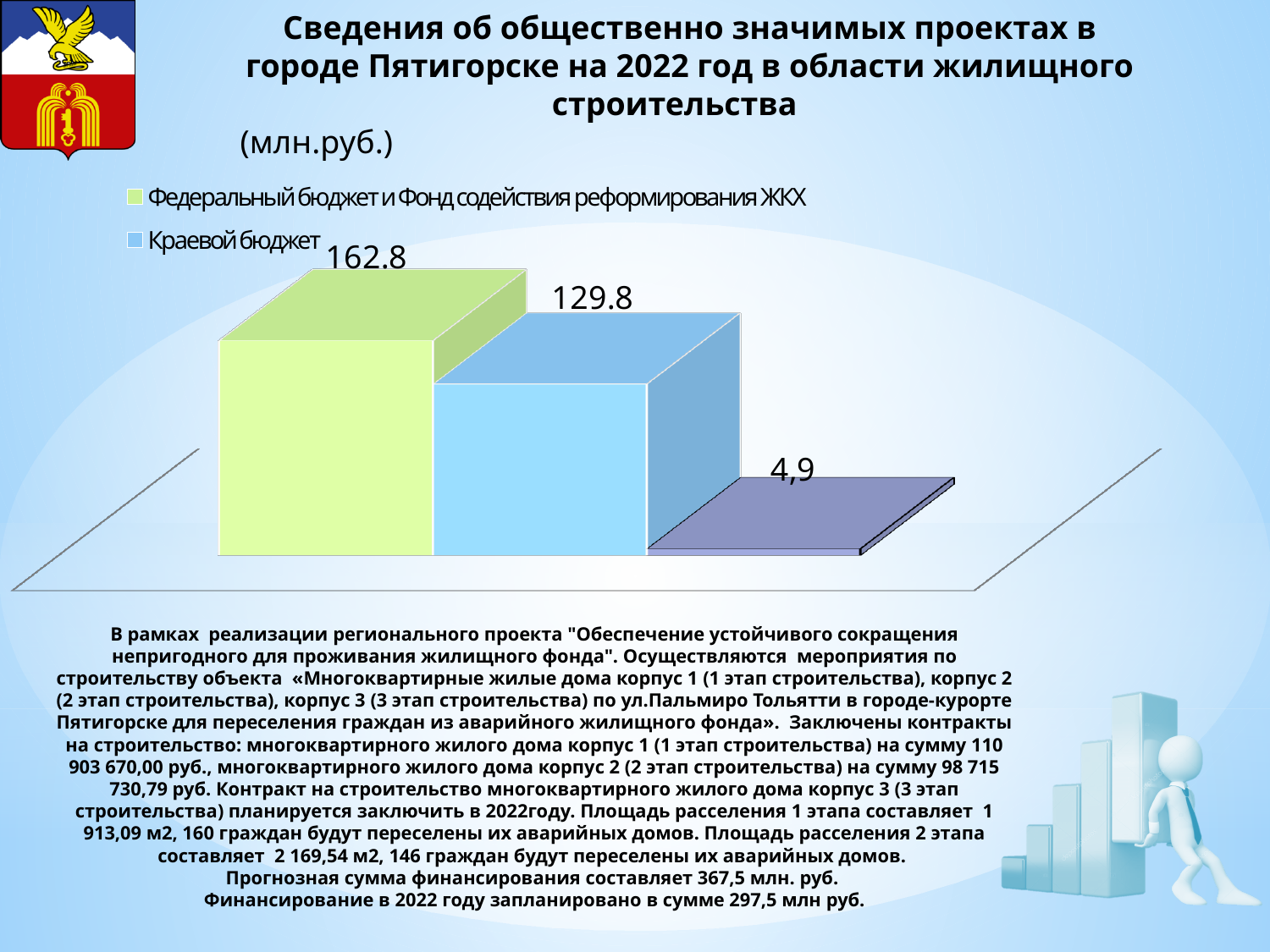
How many entries does the legend list? 2 Which legend entry has the highest value? Федеральный бюджет и Фонд содействия реформирования ЖКХ What is the smallest value shown on the chart? 4,9 What value is labelled on the smallest (purple) bar on the right? 4,9 What is the difference between the values for Федеральный бюджет и Фонд содействия реформирования ЖКХ and Краевой бюджет? 33 What is the value for Краевой бюджет? 129.8 What is the value for Федеральный бюджет и Фонд содействия реформирования ЖКХ? 162.8 What kind of chart is shown on the slide? bar chart In what units are the chart values given? млн.руб. Which is larger: Федеральный бюджет и Фонд содействия реформирования ЖКХ or Краевой бюджет? Федеральный бюджет и Фонд содействия реформирования ЖКХ How many bars are plotted on the chart? 3 What is the sum of the three values shown on the chart? 297.5